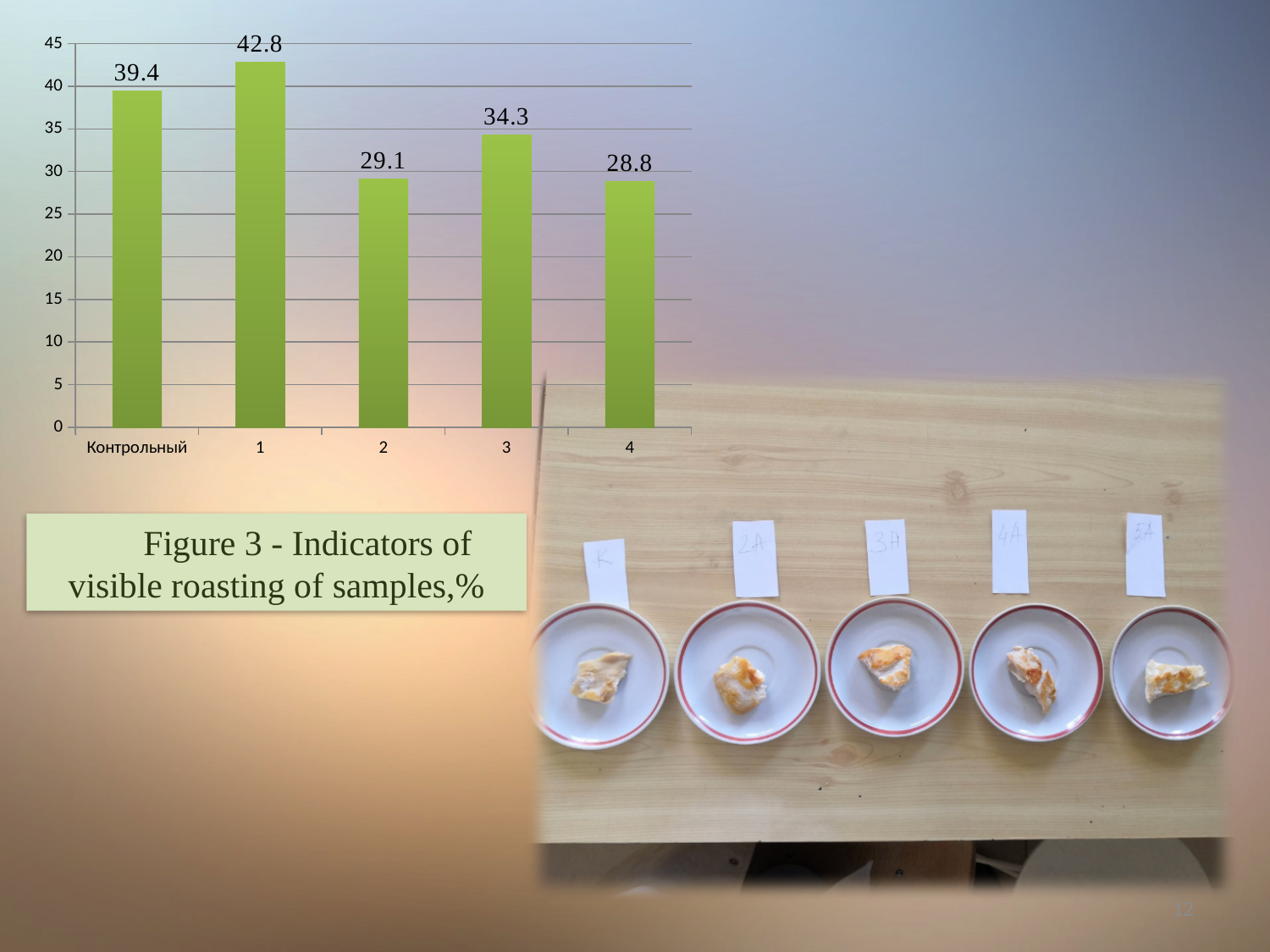
What is the value for the Контрольный (control) sample? 39.4 What is the value for sample 3? 34.3 Which category has the lowest value? 4 What is the value for sample 1? 42.8 Is the value for sample 4 greater or less than 30? less What is the caption of the figure below the chart? Figure 3 - Indicators of visible roasting of samples,% What kind of chart is shown on the slide? bar chart How many bars are shown in the chart? 5 What is the difference between the Контрольный sample and sample 3? 5.1 Which category has the highest value? 1 What is the difference between the values for sample 1 and sample 2? 13.7 Which is larger, the value for sample 2 or sample 3? 3